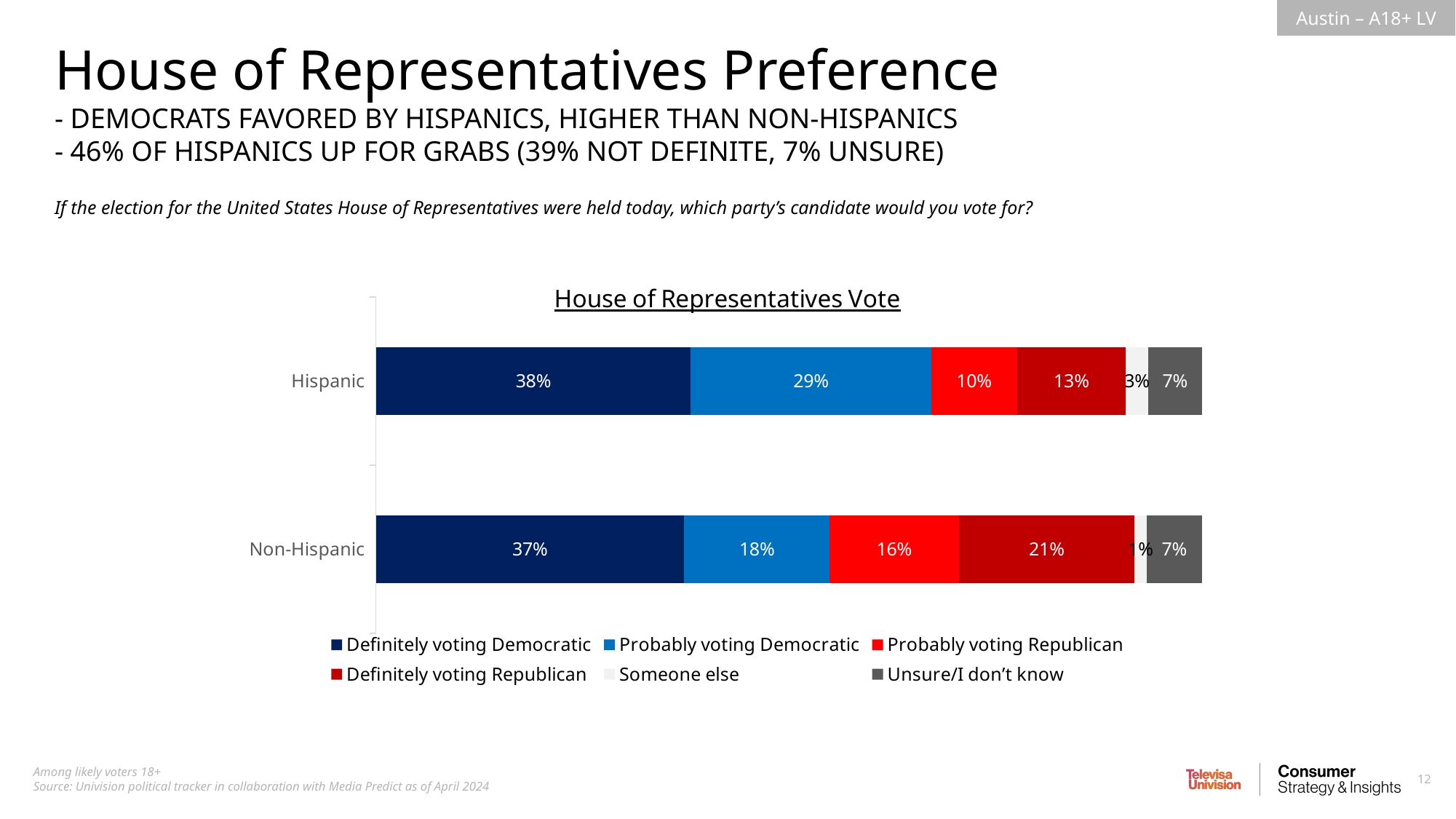
What is the title of the chart? House of Representatives Vote What is the difference between the Hispanic and Non-Hispanic shares for 'Probably voting Democratic'? 11% Which response category has the largest share among Hispanic respondents? Definitely voting Democratic Which group has a larger share for 'Definitely voting Republican', Hispanic or Non-Hispanic? Non-Hispanic What percentage of Non-Hispanic respondents are definitely voting Republican? 21% Which response category has the smallest share among Non-Hispanic respondents? Someone else How many series does the legend list? 6 How many groups (bars) are shown in the chart? 2 What percentage of Hispanic respondents chose 'Someone else'? 3% What percentage of Non-Hispanic respondents are probably voting Democratic? 18% What type of chart is shown on the slide? Stacked bar chart What percentage of Hispanic respondents are definitely voting Democratic? 38%